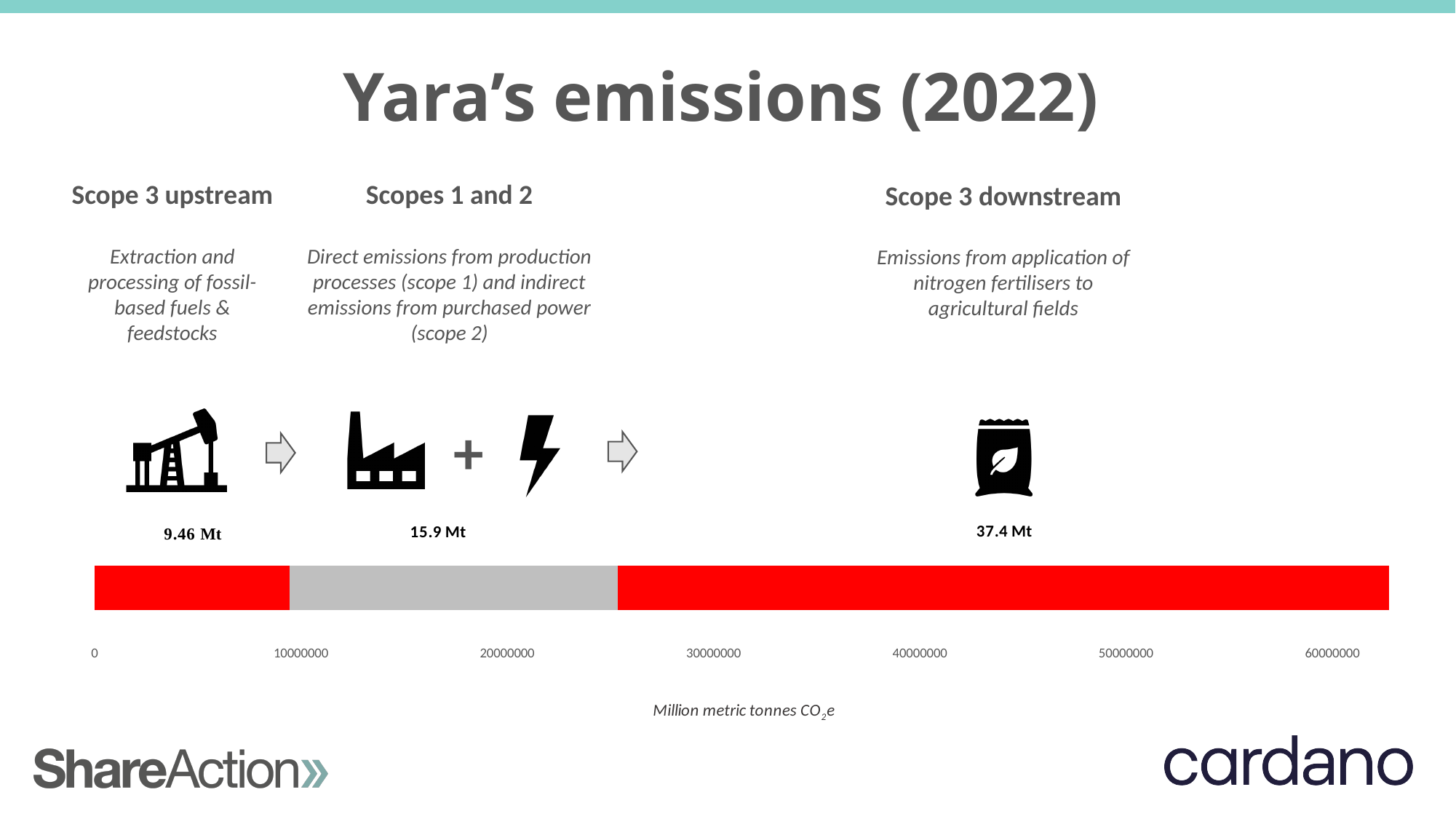
What is the total of the three emissions values shown? 62.76 Mt What is the value shown for Scope 3 upstream emissions? 9.46 Mt Which is larger, Scope 3 upstream or Scopes 1 and 2? Scopes 1 and 2 What is the value shown for Scope 3 downstream emissions? 37.4 Mt What is the value shown for Scopes 1 and 2 emissions? 15.9 Mt What is the difference between the Scope 3 downstream and Scopes 1 and 2 values? 21.5 Mt Which emissions category has the highest value? Scope 3 downstream Which emissions category has the lowest value? Scope 3 upstream How many emissions categories are shown in the bar? 3 What kind of chart is shown on the slide? Stacked bar chart Is the Scope 3 upstream segment of the bar greater or less than 10000000 on the axis? less What is the difference between the Scopes 1 and 2 value and the Scope 3 upstream value? 6.44 Mt